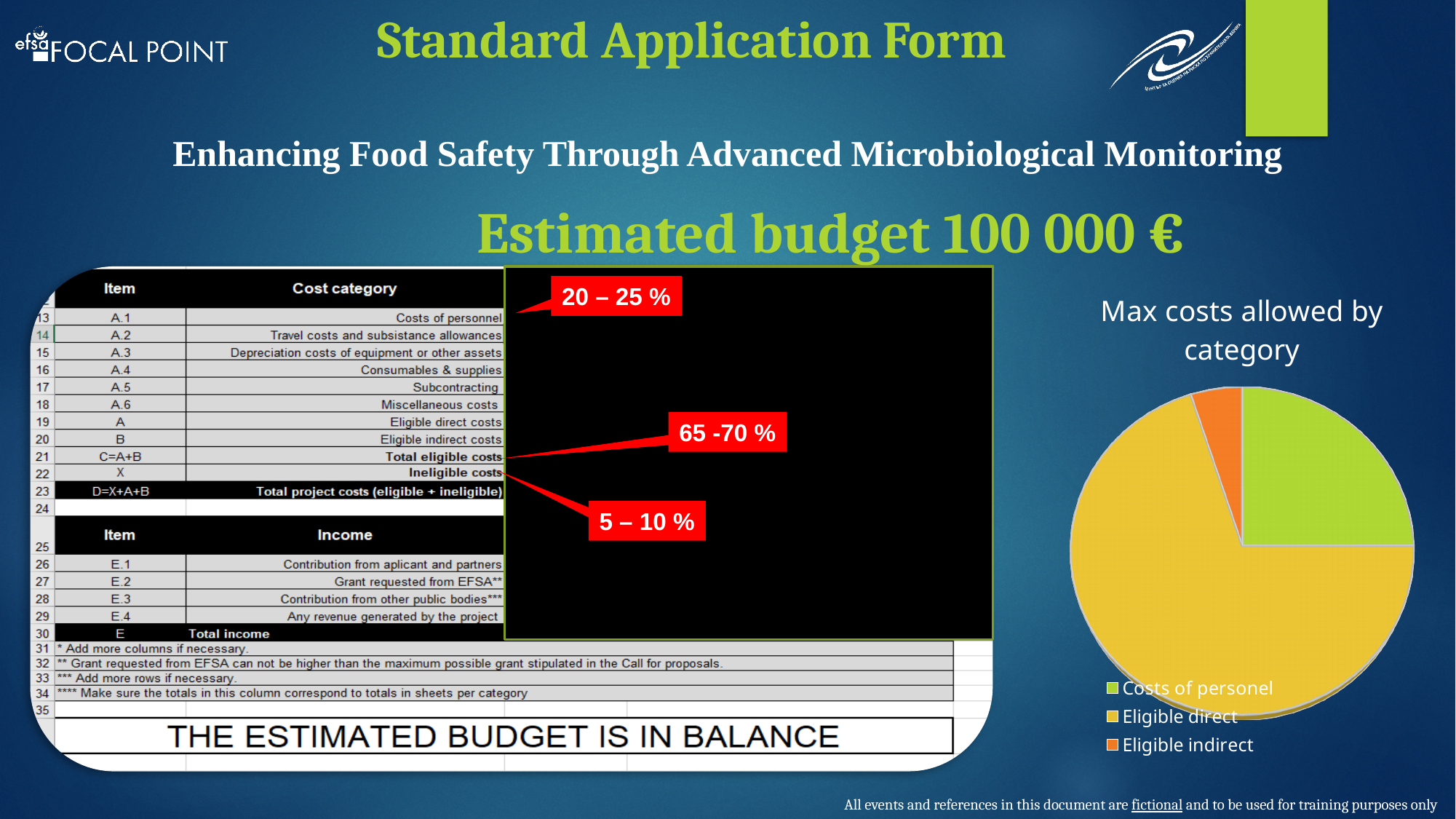
In the pie chart, which slice is larger: Eligible direct or Costs of personel? Eligible direct Which category has the largest slice in the pie chart? Eligible direct What is the title of the pie chart? Max costs allowed by category How many entries does the pie chart's legend list? 3 What kind of chart is shown on the right side of the slide? Pie chart How many categories does the pie chart show? 3 In the pie chart, which slice is larger: Costs of personel or Eligible indirect? Costs of personel What colour is the Eligible indirect slice in the pie chart? Orange Which category has the smallest slice in the pie chart? Eligible indirect